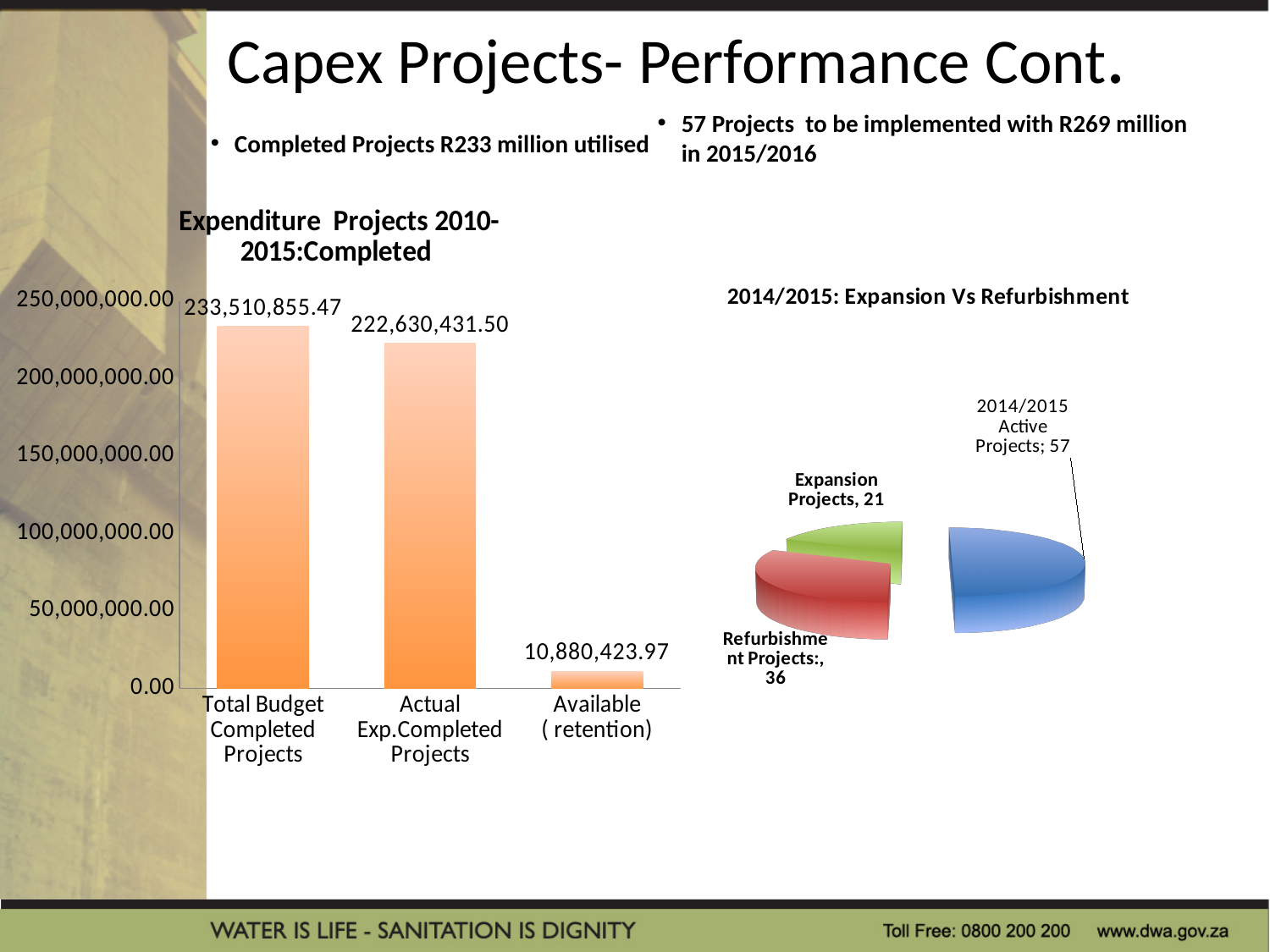
In the bar chart titled 'Expenditure Projects 2010-2015:Completed', which category has the highest value? Total Budget Completed Projects What kind of chart is the chart titled 'Expenditure Projects 2010-2015:Completed'? Bar chart In the bar chart titled 'Expenditure Projects 2010-2015:Completed', what is the value for Total Budget Completed Projects? 233,510,855.47 In the pie chart titled '2014/2015: Expansion Vs Refurbishment', what is the value for Expansion Projects? 21 In the bar chart titled 'Expenditure Projects 2010-2015:Completed', what is the difference between Total Budget Completed Projects and Actual Exp.Completed Projects? 10,880,423.97 In the bar chart titled 'Expenditure Projects 2010-2015:Completed', what is the value for Actual Exp.Completed Projects? 222,630,431.50 In the bar chart titled 'Expenditure Projects 2010-2015:Completed', how many categories are shown? 3 In the pie chart titled '2014/2015: Expansion Vs Refurbishment', what is the value for Refurbishment Projects? 36 In the bar chart titled 'Expenditure Projects 2010-2015:Completed', what is the value for Available (retention)? 10,880,423.97 What kind of chart is the chart titled '2014/2015: Expansion Vs Refurbishment'? Pie chart In the bar chart titled 'Expenditure Projects 2010-2015:Completed', which category has the lowest value? Available (retention) In the pie chart titled '2014/2015: Expansion Vs Refurbishment', which is larger, Expansion Projects or Refurbishment Projects? Refurbishment Projects